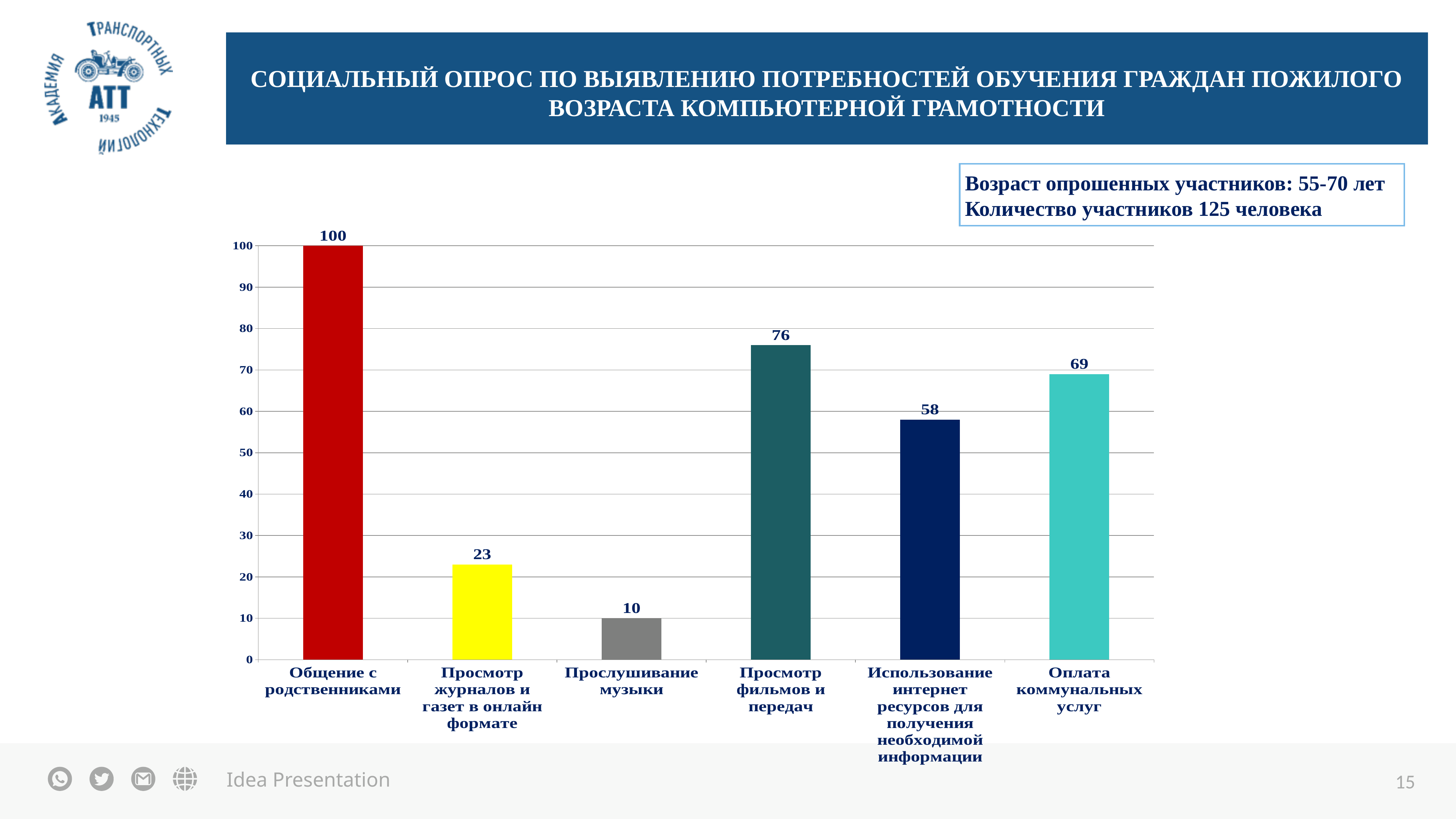
What is the value for Просмотр фильмов и передач? 76 What colour is the bar for Просмотр журналов и газет в онлайн формате? yellow What is the difference between the values for Просмотр журналов и газет в онлайн формате and Прослушивание музыки? 13 What is the value for Использование интернет ресурсов для получения необходимой информации? 58 Which category has the highest value? Общение с родственниками What is the difference between the values for Общение с родственниками and Просмотр фильмов и передач? 24 How many categories are shown in the chart? 6 Which category has the lowest value? Прослушивание музыки Which is larger: the value for Оплата коммунальных услуг or the value for Использование интернет ресурсов для получения необходимой информации? Оплата коммунальных услуг What is the value for Общение с родственниками? 100 What kind of chart is shown on the slide? bar chart What is the value for Оплата коммунальных услуг? 69